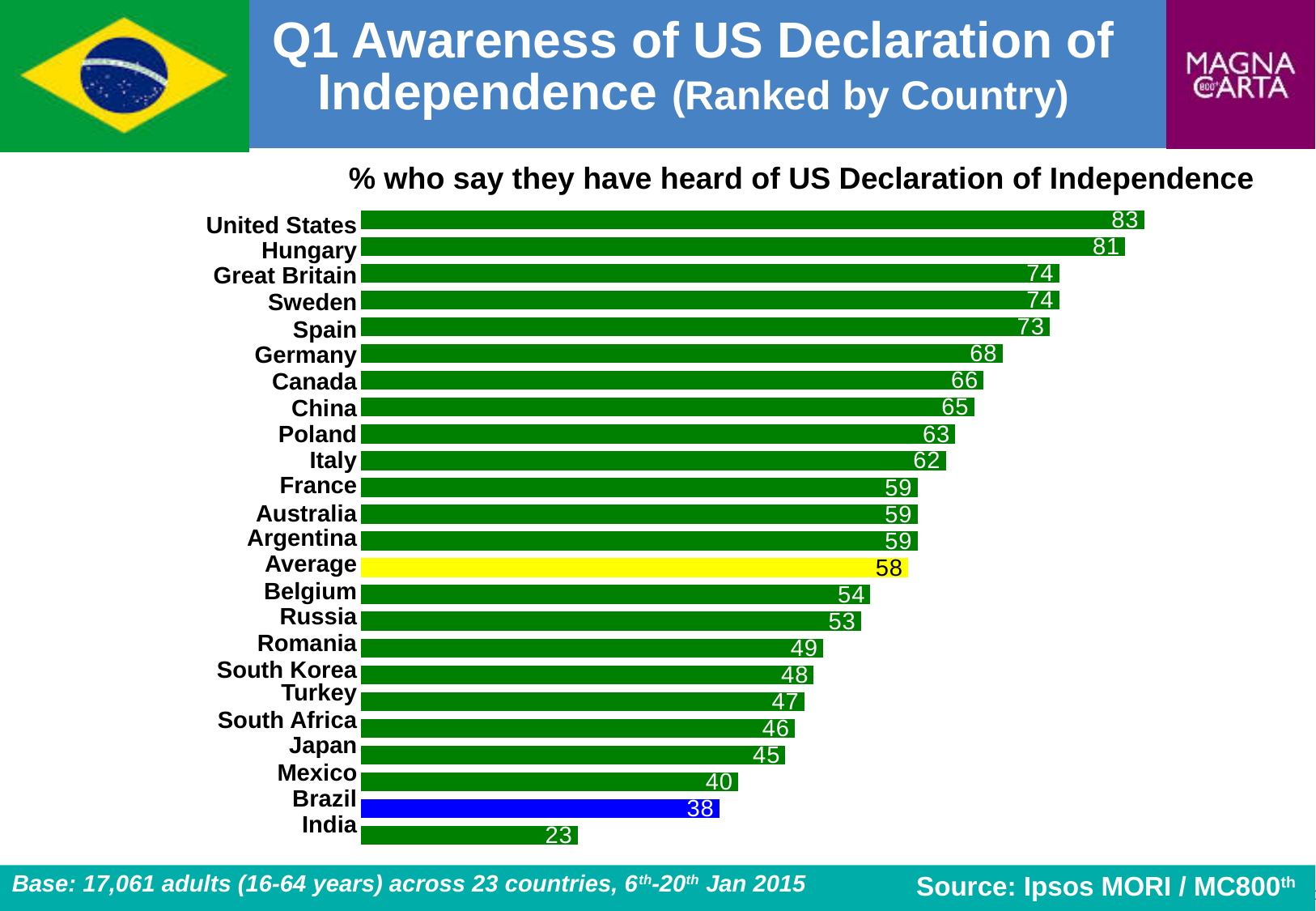
What is the value shown for Brazil? 38 How many bars are plotted in the chart, including the Average bar? 24 What kind of chart is shown on the slide? Bar chart What is the difference between the values for Brazil and the Average? 20 What percentage of respondents in the United States say they have heard of the US Declaration of Independence? 83 Which country has the lowest percentage who say they have heard of the US Declaration of Independence? India Which bar in the chart is coloured blue? Brazil What is the difference between the values for the United States and India? 60 Which country has the highest percentage who say they have heard of the US Declaration of Independence? United States What is the value shown for the Average bar? 58 What is the value shown for Germany? 68 Which has a higher value, Canada or Belgium? Canada